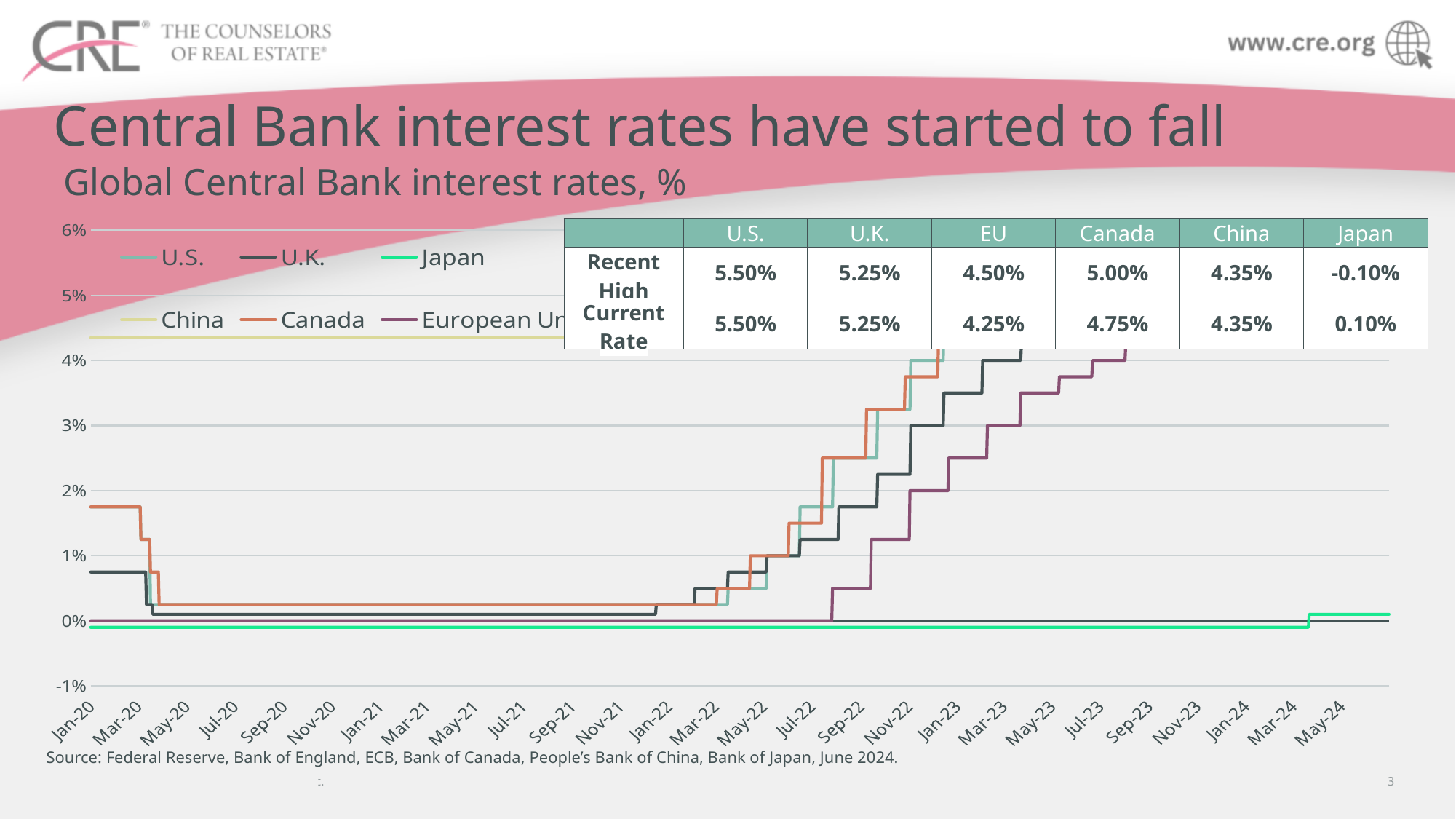
Is the Japan rate in Jan-23 greater or less than 1%? less According to the table on the chart, which central bank has the lowest Current Rate? Japan What is the chart's title? Global Central Bank interest rates, % According to the table on the chart, what is the Recent High for the EU? 4.50% According to the table on the chart, which central bank has the highest Recent High? U.S. What kind of chart is shown on the slide? line chart According to the table on the chart, what is the Current Rate for Canada? 4.75% Does the U.S. line rise or fall between Jan-22 and Jan-23? rise In Jan-20, which line is higher, Canada or U.K.? Canada How many series does the chart legend list? 6 Is the Canada rate in Jan-20 greater or less than 2%? less According to the table, what is the difference between Canada's Recent High and its Current Rate? 0.25%